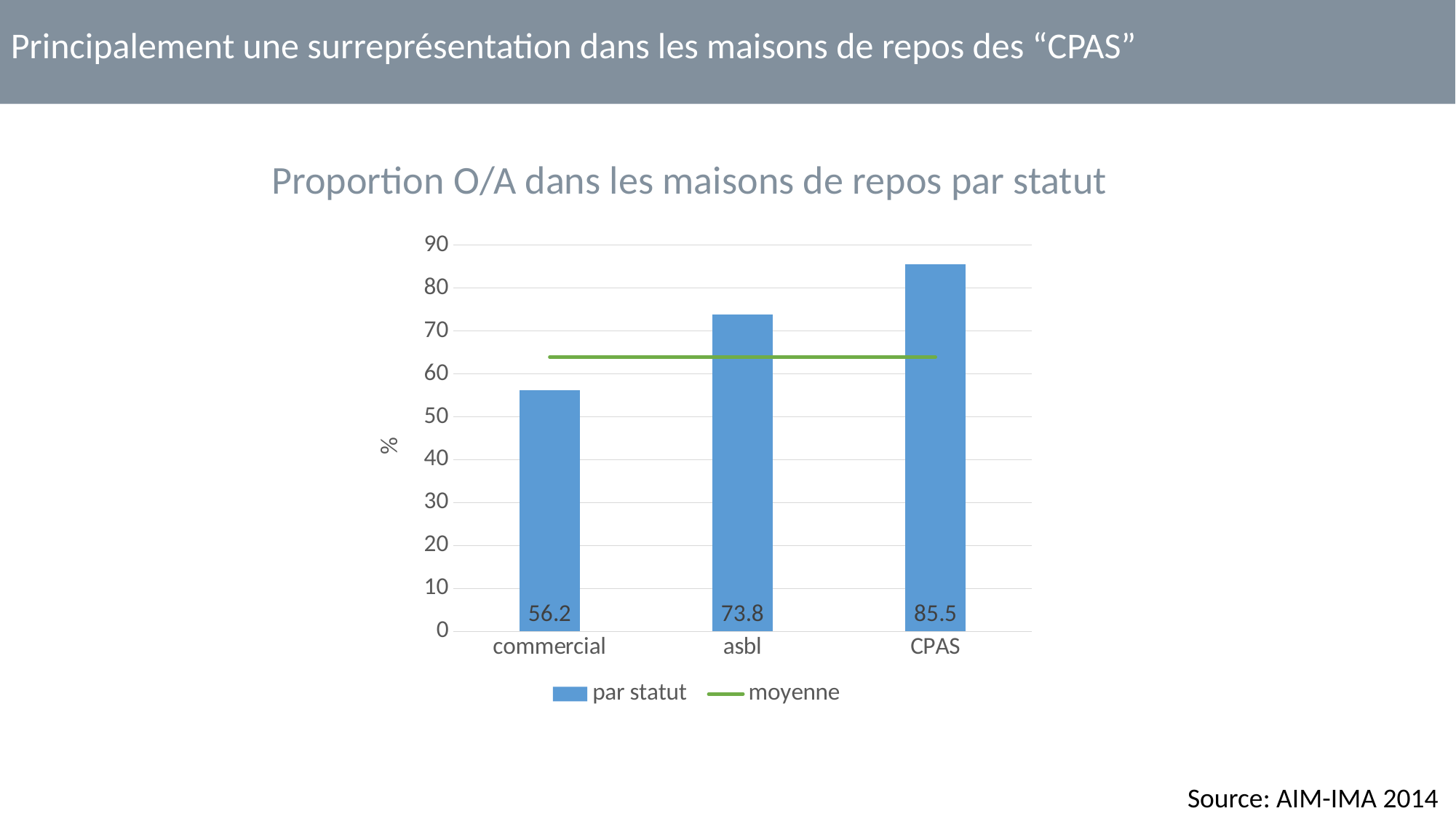
How many series does the legend list? 2 Which is larger, the value for asbl or the value for commercial? asbl Which category has the lowest 'par statut' value? commercial Which category has the highest 'par statut' value? CPAS What is the difference between the CPAS value and the commercial value? 29.3 What kind of chart is used for the 'par statut' series? bar chart How many categories are shown on the x axis? 3 What is the value for asbl in the 'par statut' series? 73.8 What is the title of the chart? Proportion O/A dans les maisons de repos par statut What is the value for commercial in the 'par statut' series? 56.2 Is the 'moyenne' line greater or less than 60? greater What is the value for CPAS in the 'par statut' series? 85.5